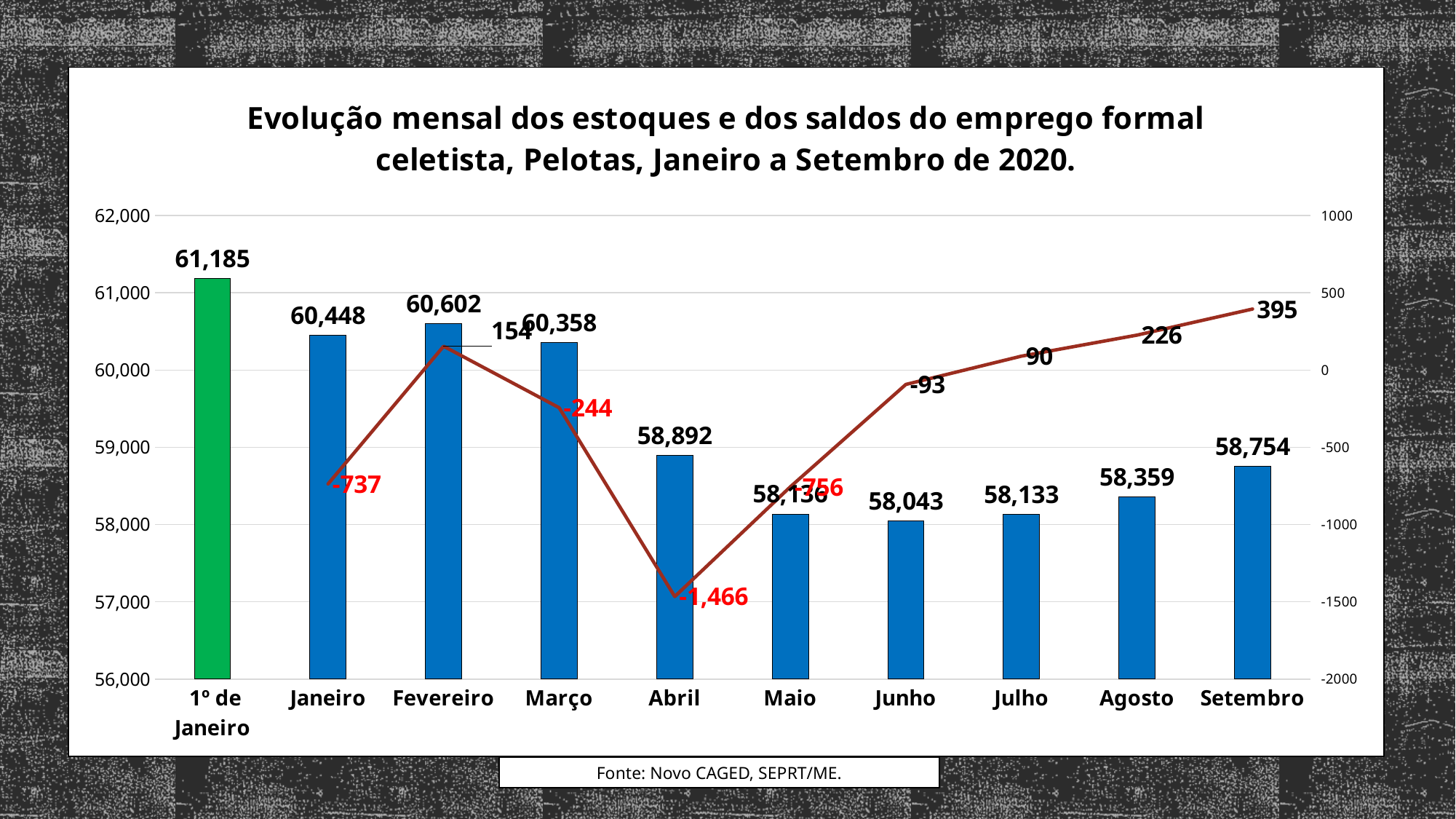
What is the line value (saldo) shown for Setembro? 395 What is the value of the bar for Setembro? 58,754 Which month has the lowest line value (saldo)? Abril How many bars are plotted in the chart? 10 What is the value of the bar for Fevereiro? 60,602 What is the stock value shown for the bar labelled 1º de Janeiro? 61,185 What is the line value (saldo) shown for Abril? -1,466 Which month has the lowest bar value? Junho What is the difference between the bar values for Fevereiro and Março? 244 What colour is the bar for 1º de Janeiro? Green What kind of chart is shown on the slide? Combined bar and line chart Which bar is taller, Agosto or Julho? Agosto